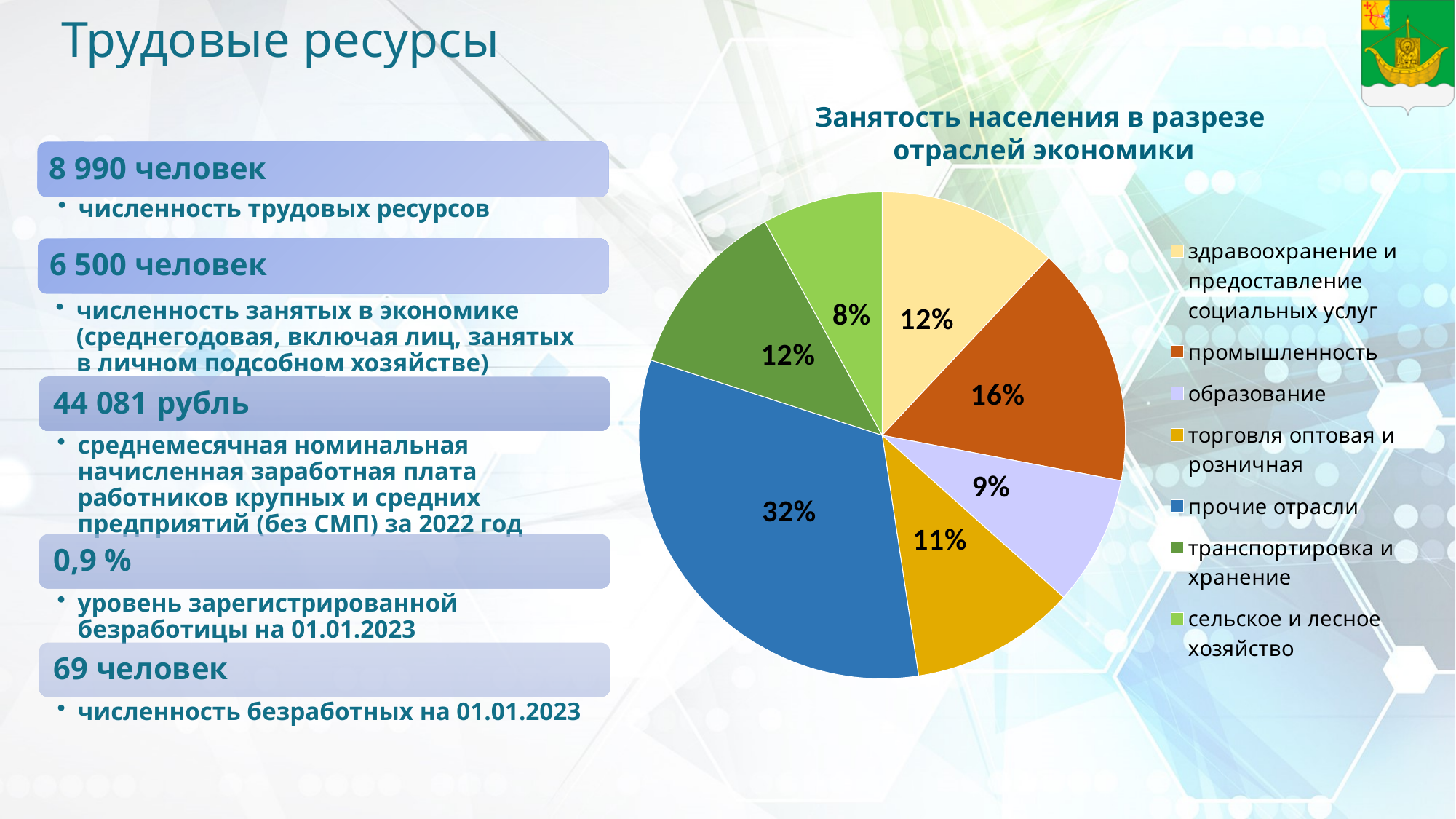
How many slices does the pie chart have? 7 What is the difference between the shares of 'промышленность' and 'торговля оптовая и розничная'? 5% Which category has the smallest share of the pie? сельское и лесное хозяйство Which colour represents 'прочие отрасли' in the legend? blue Which is larger: the share of 'образование' or the share of 'транспортировка и хранение'? транспортировка и хранение What is the value for 'промышленность'? 16% What is the value for 'сельское и лесное хозяйство'? 8% What is the value for 'образование'? 9% What is the title of the chart? Занятость населения в разрезе отраслей экономики Which category has the largest share of the pie? прочие отрасли What share of the pie is 'прочие отрасли'? 32% What kind of chart is shown on the slide? pie chart